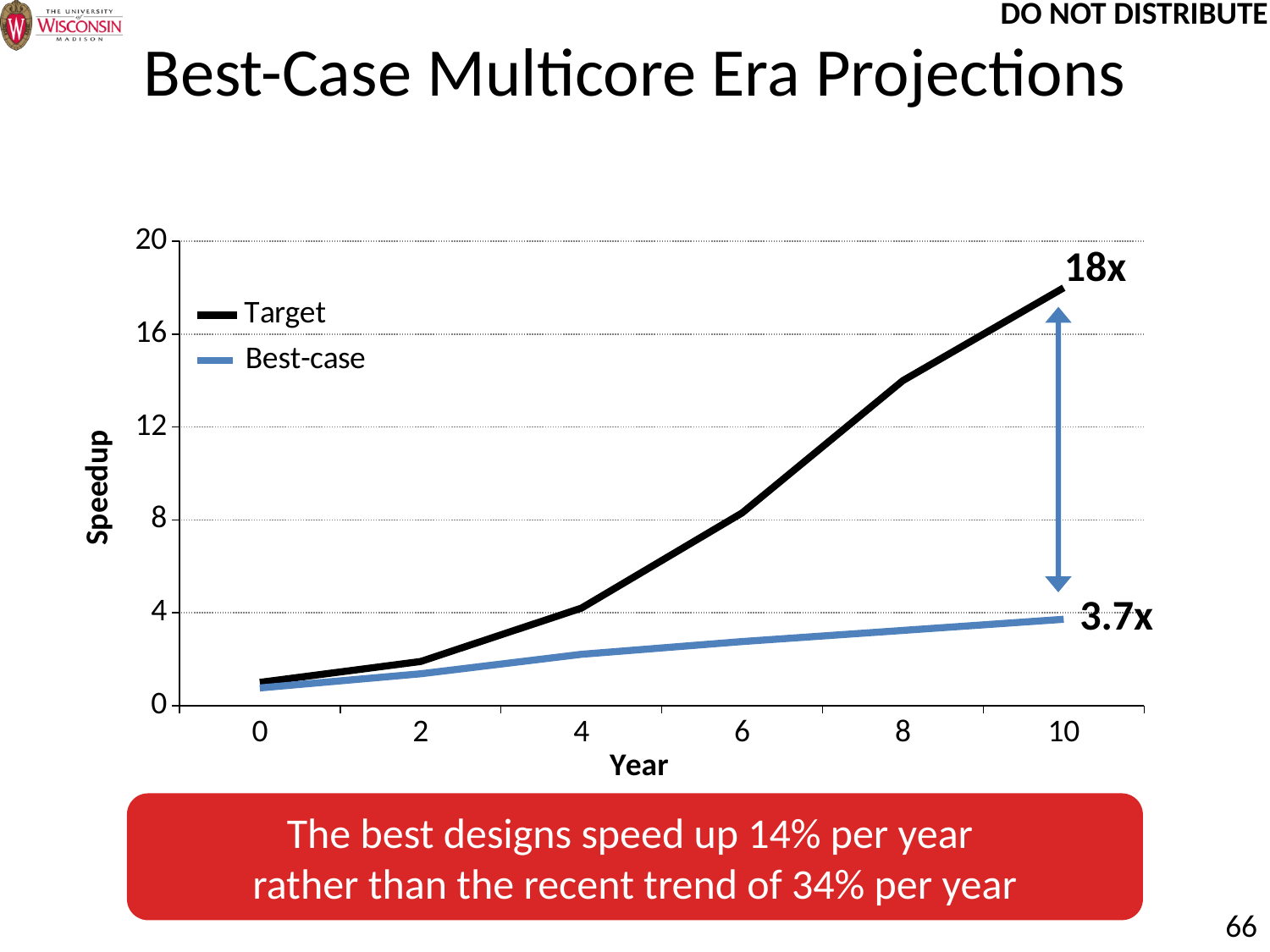
What kind of chart is shown on the slide? line chart What is the Best-case speedup at year 10? 3.7x Which series has the higher speedup at year 10, Target or Best-case? Target What is the label of the y axis? Speedup Is the Target speedup at year 8 greater or less than 12? greater Does the Best-case speedup rise or fall as the year increases? rise What is the Target speedup at year 10? 18x Is the Best-case speedup at year 6 greater or less than 4? less What is the title of the slide containing the chart? Best-Case Multicore Era Projections Does the Target speedup rise or fall as the year increases? rise How many series does the legend list? 2